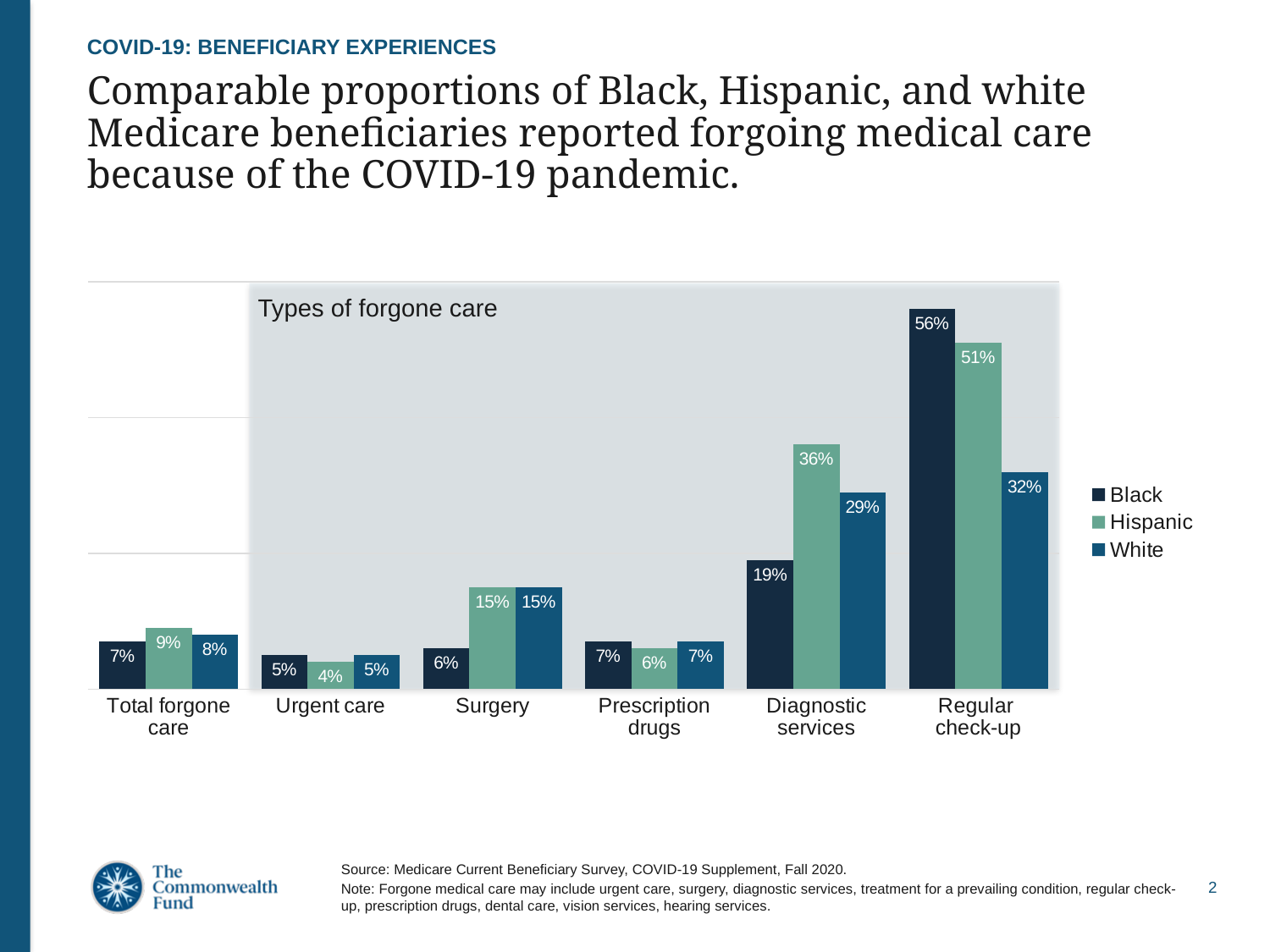
Which category has the lowest value for Hispanic beneficiaries? Urgent care What is the value for Hispanic beneficiaries in the Diagnostic services category? 36% For Diagnostic services, which group has the larger value: Black or White? White What is the difference between the Black and White values for Regular check-up? 24% What is the value for White beneficiaries in the Total forgone care category? 8% What is the value for Hispanic beneficiaries in the Urgent care category? 4% Which category has the highest value for White beneficiaries? Regular check-up How many series does the legend list? 3 How many categories are shown on the x axis? 6 What percentage of Black Medicare beneficiaries reported forgoing a regular check-up? 56% What type of chart is shown on the slide? Bar chart What is the difference between the Hispanic and Black values for Diagnostic services? 17%